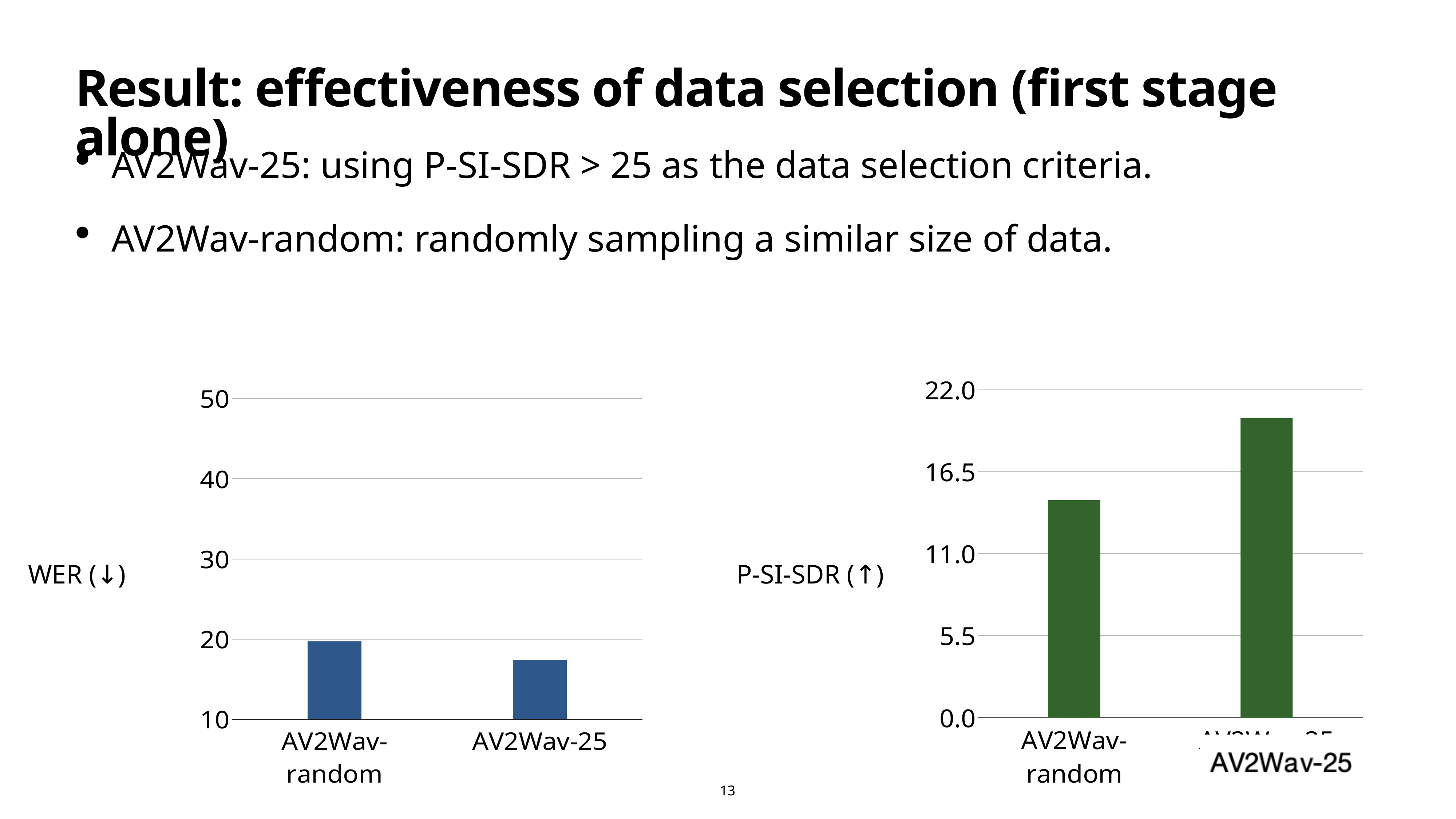
What colour are the bars on the right chart (P-SI-SDR)? green On the right chart (P-SI-SDR), which category has the lower bar? AV2Wav-random On the left chart (WER), which category has the lower bar? AV2Wav-25 How many categories are shown on the left chart (WER)? 2 On the left chart (WER), which category has the higher bar? AV2Wav-random On the right chart (P-SI-SDR), is the value for AV2Wav-25 greater or less than 22.0? less On the right chart (P-SI-SDR), which category has the higher bar? AV2Wav-25 On the left chart (WER), is the value for AV2Wav-random larger or smaller than the value for AV2Wav-25? larger On the right chart (P-SI-SDR), is the value for AV2Wav-random greater or less than 16.5? less What kind of chart is the right chart (P-SI-SDR)? bar chart On the left chart (WER), is the value for AV2Wav-25 greater or less than 20? less